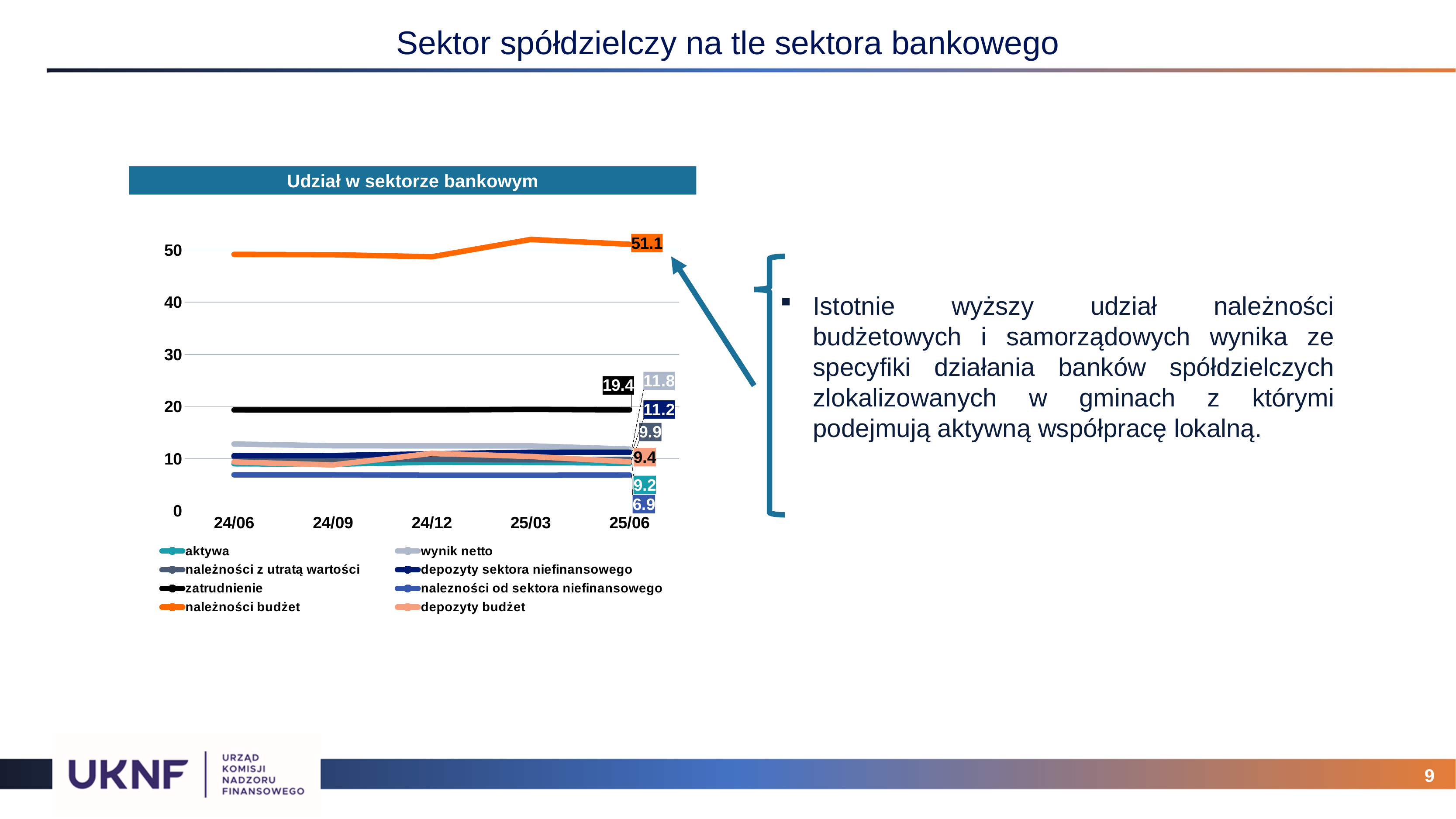
What is the difference between należności budżet and zatrudnienie at 25/06? 31.7 What is the value of zatrudnienie at 25/06? 19.4 Which series has the lowest value at 25/06? należności od sektora niefinansowego How many series does the legend list? 8 At 25/06, which is larger: depozyty sektora niefinansowego or aktywa? depozyty sektora niefinansowego What is the value of wynik netto at 25/06? 11.8 Which series has the highest value at 25/06? należności budżet How many time points are shown on the x axis? 5 What is the value of należności od sektora niefinansowego at 25/06? 6.9 What is the value of należności budżet at 25/06? 51.1 Is the value for należności budżet at 24/06 greater or less than 40? greater What kind of chart is shown? line chart